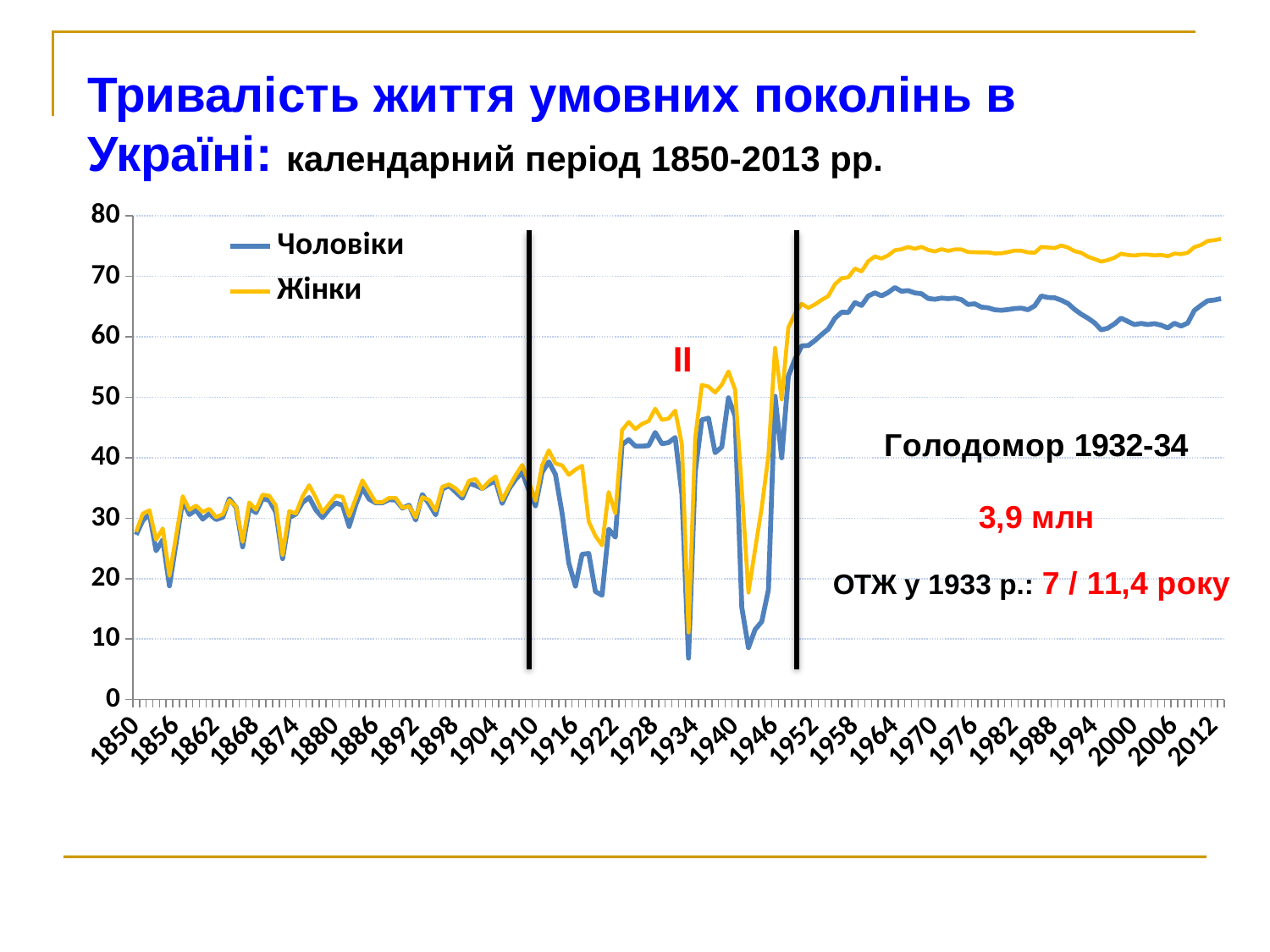
What are the two series named in the legend? Чоловіки and Жінки What calendar period does the chart title say is covered? 1850-2013 рр. By how many years did women's life expectancy exceed men's in 1933, according to the annotation? 4,4 року Is the value for Чоловіки in 1856 greater or less than 30? less How many series does the legend list? 2 According to the annotation, what was the life expectancy (ОТЖ) for men in 1933? 7 років Is the value for Жінки in 2012 greater or less than 70? greater What kind of chart is shown on the slide? line chart In 2012, which series has the higher value, Чоловіки or Жінки? Жінки Is the value for Чоловіки in 2012 greater or less than 60? greater According to the annotation, what was the life expectancy (ОТЖ) for women in 1933? 11,4 року Between 1952 and 1964, do the values for Жінки rise or fall? rise